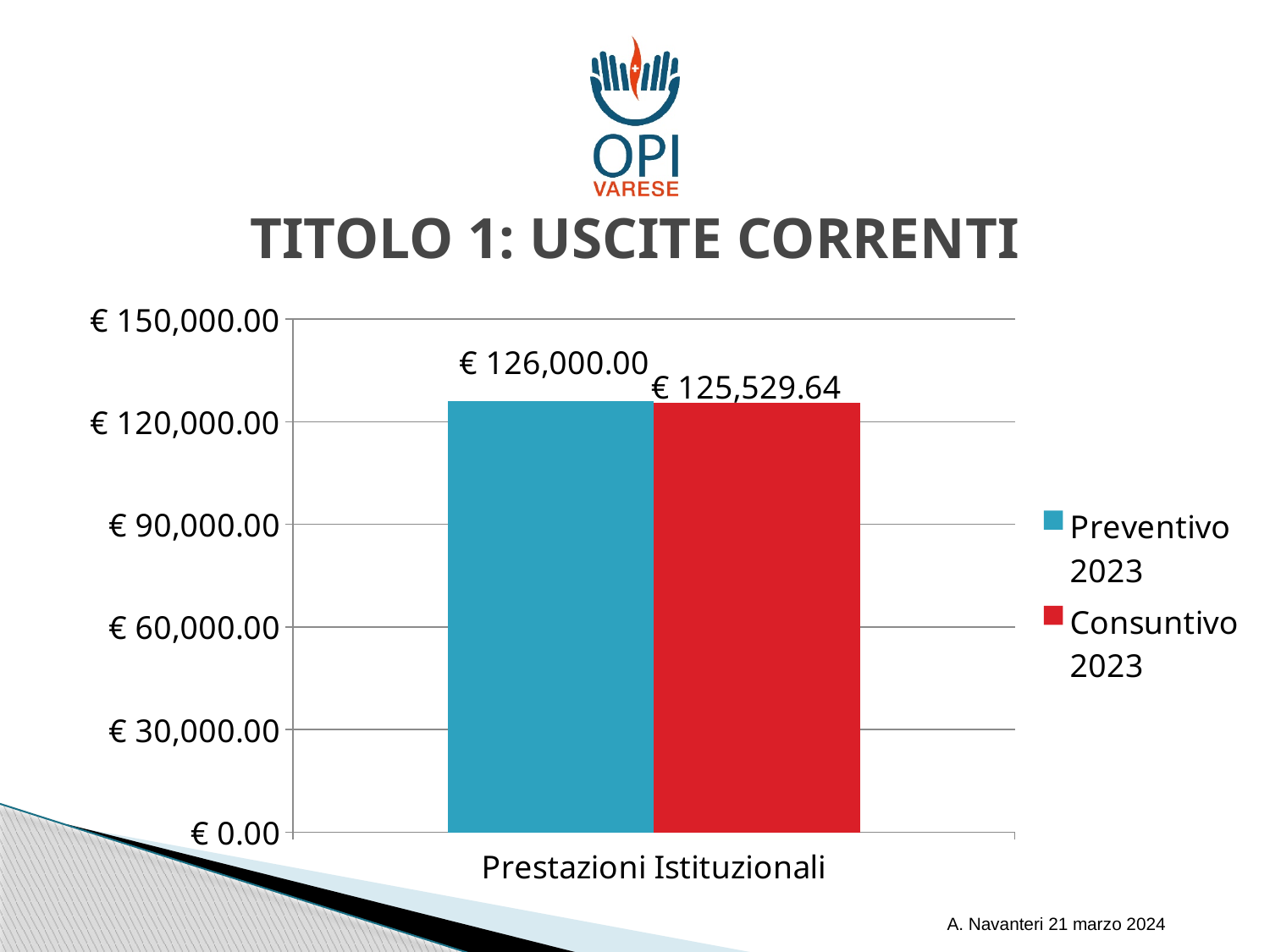
What is the title of the chart? TITOLO 1: USCITE CORRENTI What is the value for Preventivo 2023 for Prestazioni Istituzionali? € 126,000.00 How many categories are shown on the x axis of the chart? 1 What is the value for Consuntivo 2023 for Prestazioni Istituzionali? € 125,529.64 How many series does the legend list? 2 What is the category label shown on the x axis? Prestazioni Istituzionali Is the value for Preventivo 2023 greater or less than € 150,000.00? less Which series has the higher value for Prestazioni Istituzionali, Preventivo 2023 or Consuntivo 2023? Preventivo 2023 What colour is the bar for Consuntivo 2023? red What is the difference between the Preventivo 2023 and Consuntivo 2023 values for Prestazioni Istituzionali? € 470.36 Is the value for Consuntivo 2023 greater or less than € 120,000.00? greater What kind of chart is shown on the slide? bar chart